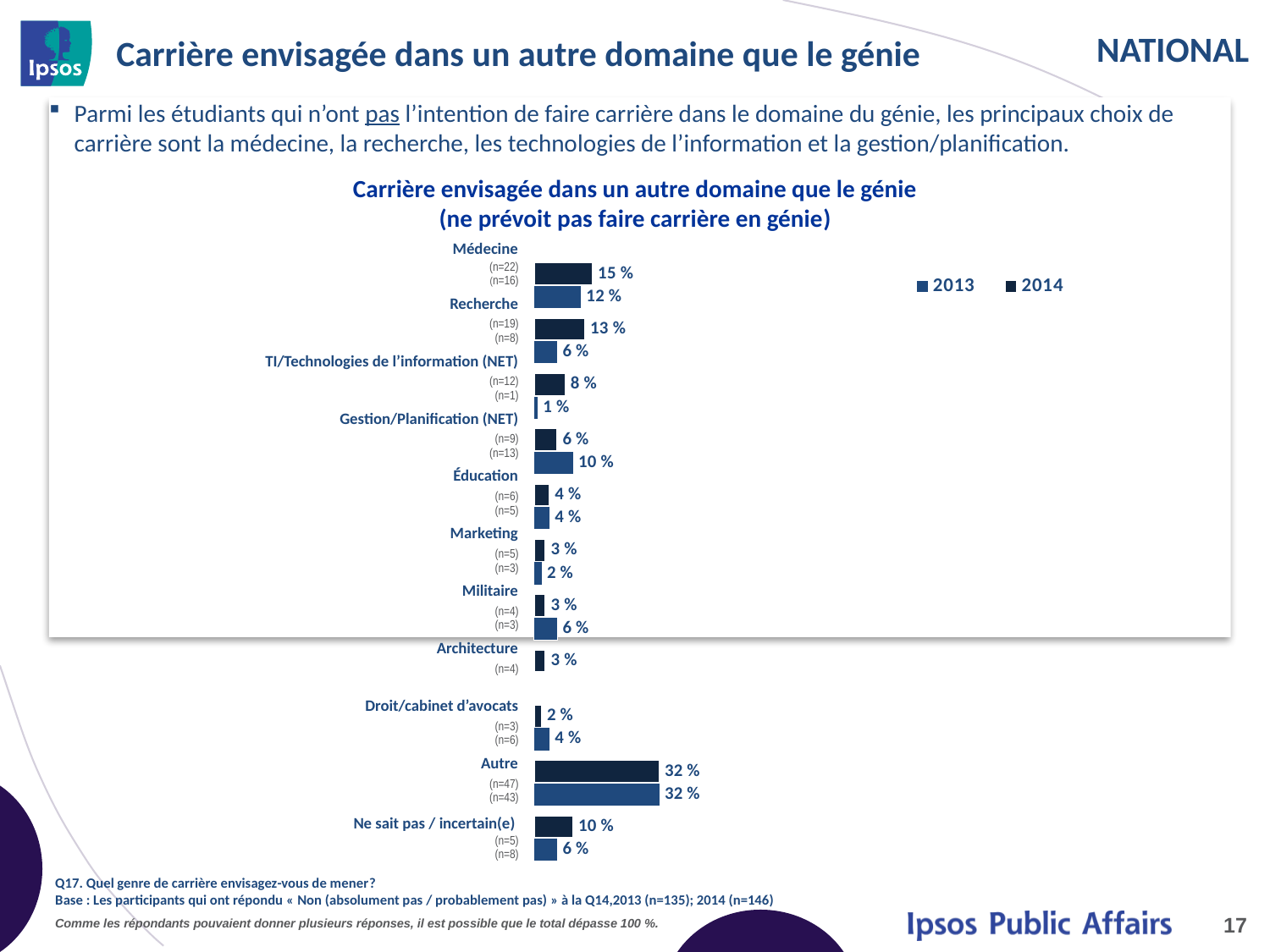
What is the 2014 value for TI/Technologies de l'information (NET)? 8 % What kind of chart is shown on the slide? Bar chart Which is larger for Ne sait pas / incertain(e), the 2013 value or the 2014 value? 2014 How many categories are shown in the chart? 11 What are the two series named in the legend? 2013 and 2014 Which category has the lowest value in 2014? Droit/cabinet d'avocats Which is larger for Militaire, the 2013 value or the 2014 value? 2013 What is the difference between the 2013 and 2014 values for Recherche? 7 % Which category has the highest value in 2013? Autre What is the 2014 value for Gestion/Planification (NET)? 6 % What is the 2013 value for Médecine? 12 % How many series does the legend list? 2